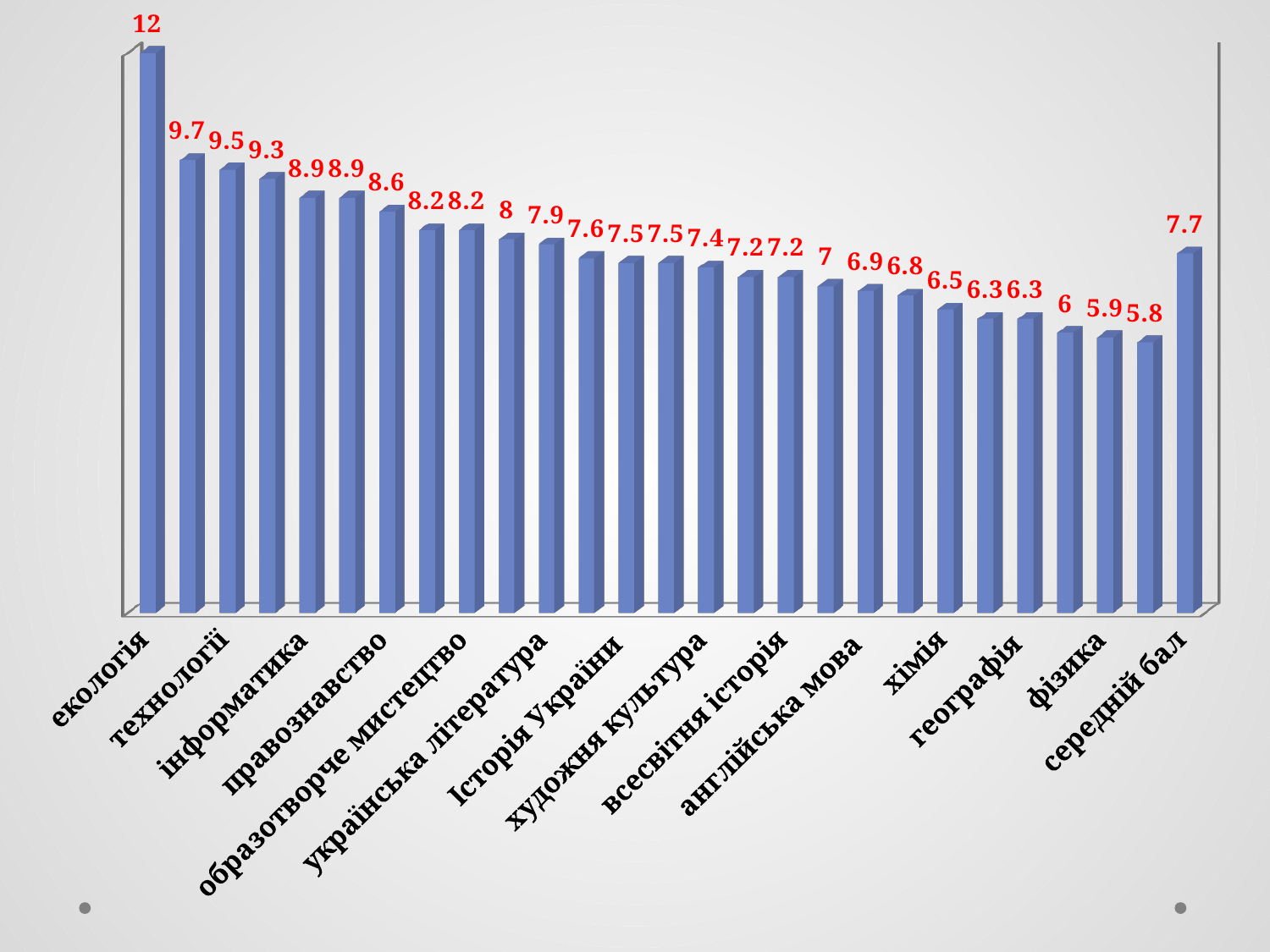
Do the values generally rise or fall from left to right across the bars before the final середній бал bar? fall Which category has the highest value? екологія What is the lowest value shown on the chart? 5.8 What is the difference between the value for екологія and the value for середній бал? 4.3 What is the value for середній бал? 7.7 What is the value for екологія? 12 What colour are the bars on the chart? blue What colour are the data labels above the bars? red Which is larger, the value for екологія or the value for середній бал? екологія How many bars are plotted on the chart? 27 What type of chart is shown on the slide? bar chart What is the highest value shown on the chart? 12